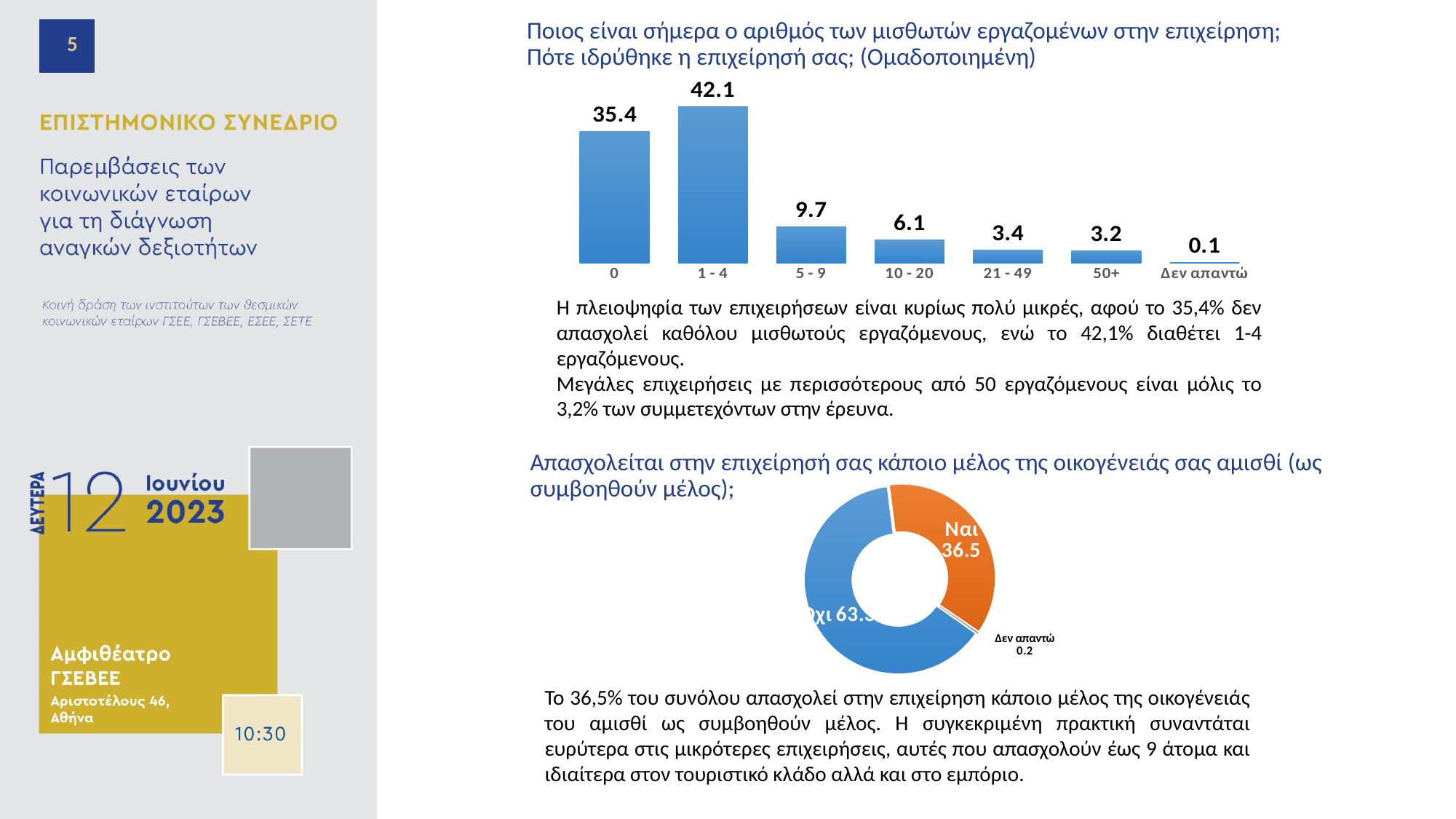
What type of chart is the top chart on the slide? Bar chart In the bottom doughnut chart, what is the value for 'Ναι'? 36.5 In the top bar chart, which category has the lowest value? Δεν απαντώ In the bottom doughnut chart, which slice is larger, 'Ναι' or 'Όχι'? Όχι In the bottom doughnut chart, what is the value for 'Δεν απαντώ'? 0.2 In the top bar chart, which is larger, the value for '5 - 9' or the value for '10 - 20'? 5 - 9 In the top bar chart, what is the value for the '0' category? 35.4 In the top bar chart, what is the difference between the values for '1 - 4' and '0'? 6.7 In the top bar chart, which category has the highest value? 1 - 4 How many categories are shown in the top bar chart? 7 In the top bar chart, what is the value for the '50+' category? 3.2 In the top bar chart, what is the value for the '1 - 4' category? 42.1